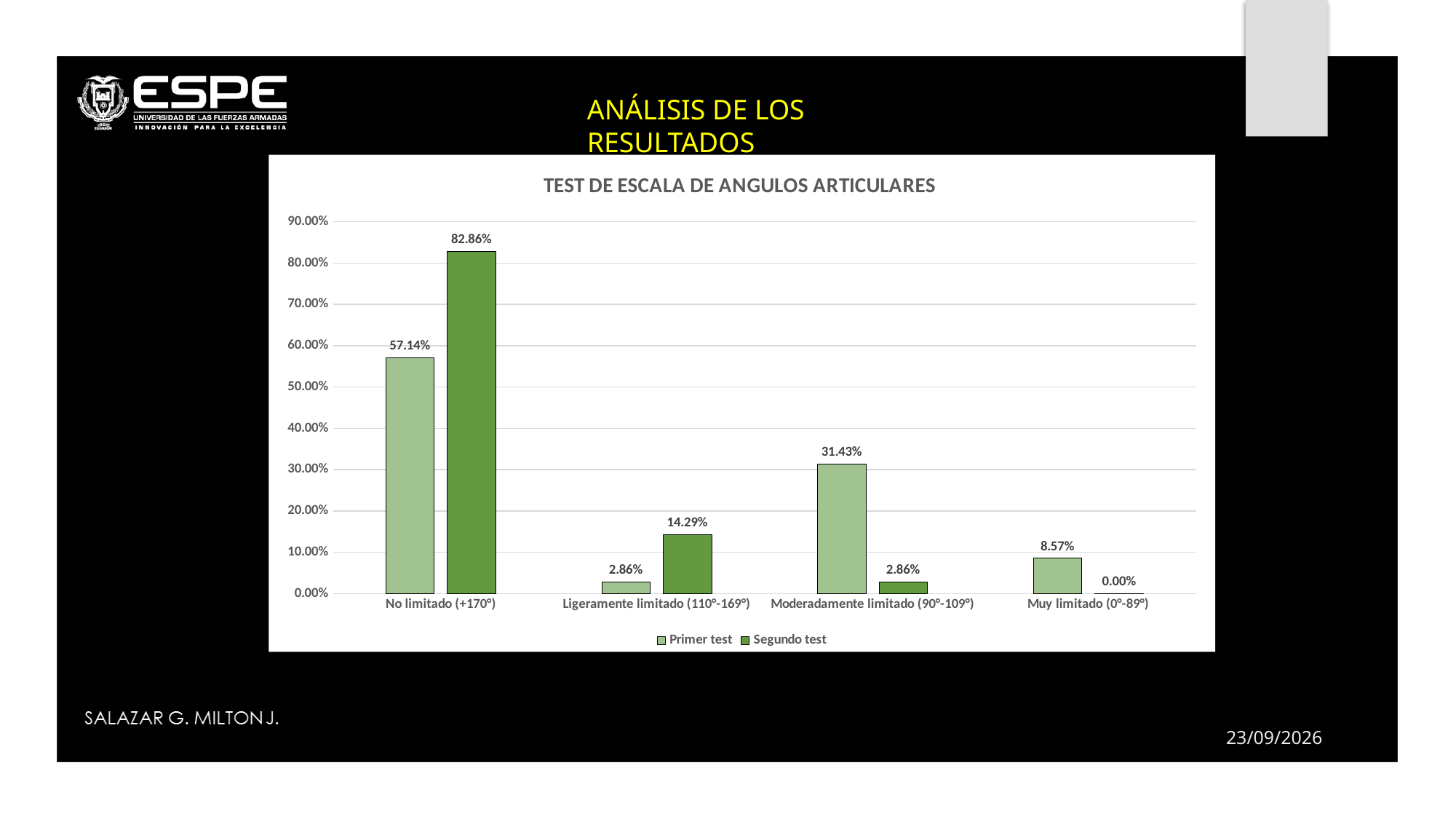
What is the difference between the Segundo test and Primer test values in the No limitado (+170°) category? 25.72% In the Moderadamente limitado (90°-109°) category, which series has the larger value, Primer test or Segundo test? Primer test Which category has the lowest Primer test value? Ligeramente limitado (110°-169°) How many categories are shown on the x axis? 4 What is the value for Primer test in the No limitado (+170°) category? 57.14% What is the value for Primer test in the Moderadamente limitado (90°-109°) category? 31.43% What is the value for Segundo test in the No limitado (+170°) category? 82.86% What is the value for Segundo test in the Muy limitado (0°-89°) category? 0.00% What is the value for Segundo test in the Ligeramente limitado (110°-169°) category? 14.29% What type of chart is shown on the slide? Bar chart How many series does the legend list? 2 Which category has the highest Segundo test value? No limitado (+170°)